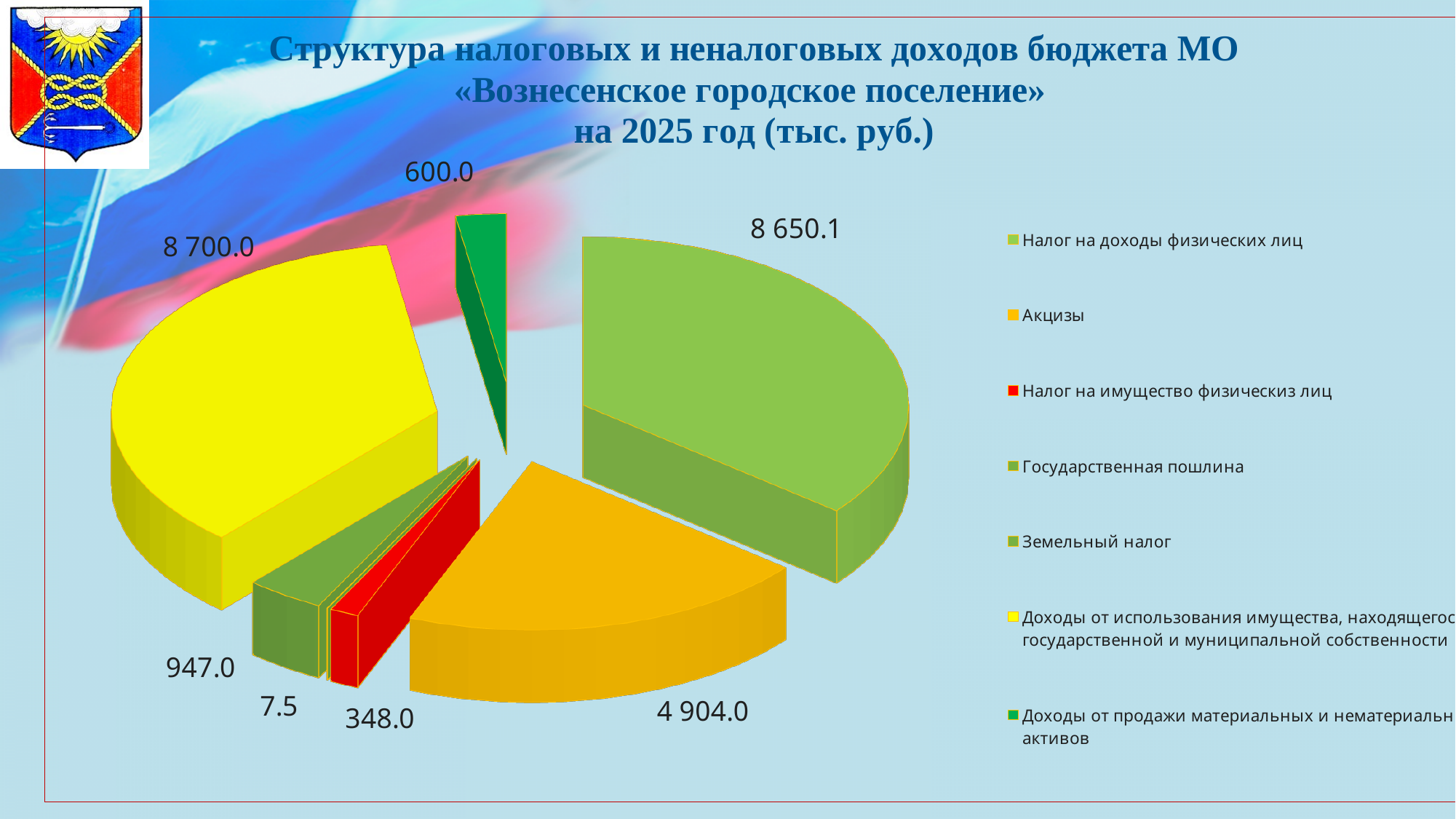
Which is larger: the value for Налог на доходы физических лиц or the value for Акцизы? Налог на доходы физических лиц What is the value for Налог на доходы физических лиц? 8 650.1 Which category has the smallest value? Государственная пошлина What is the difference between the values for Акцизы and Земельный налог? 3 957.0 How many slices does the pie chart have? 7 What is the value for Земельный налог? 947.0 What is the value for Налог на имущество физических лиц? 348.0 Which category has the largest value? Доходы от использования имущества, находящегося в государственной и муниципальной собственности What is the value for Государственная пошлина? 7.5 What type of chart is shown on the slide? pie chart What is the value for Акцизы? 4 904.0 What colour is the slice for Акцизы? orange